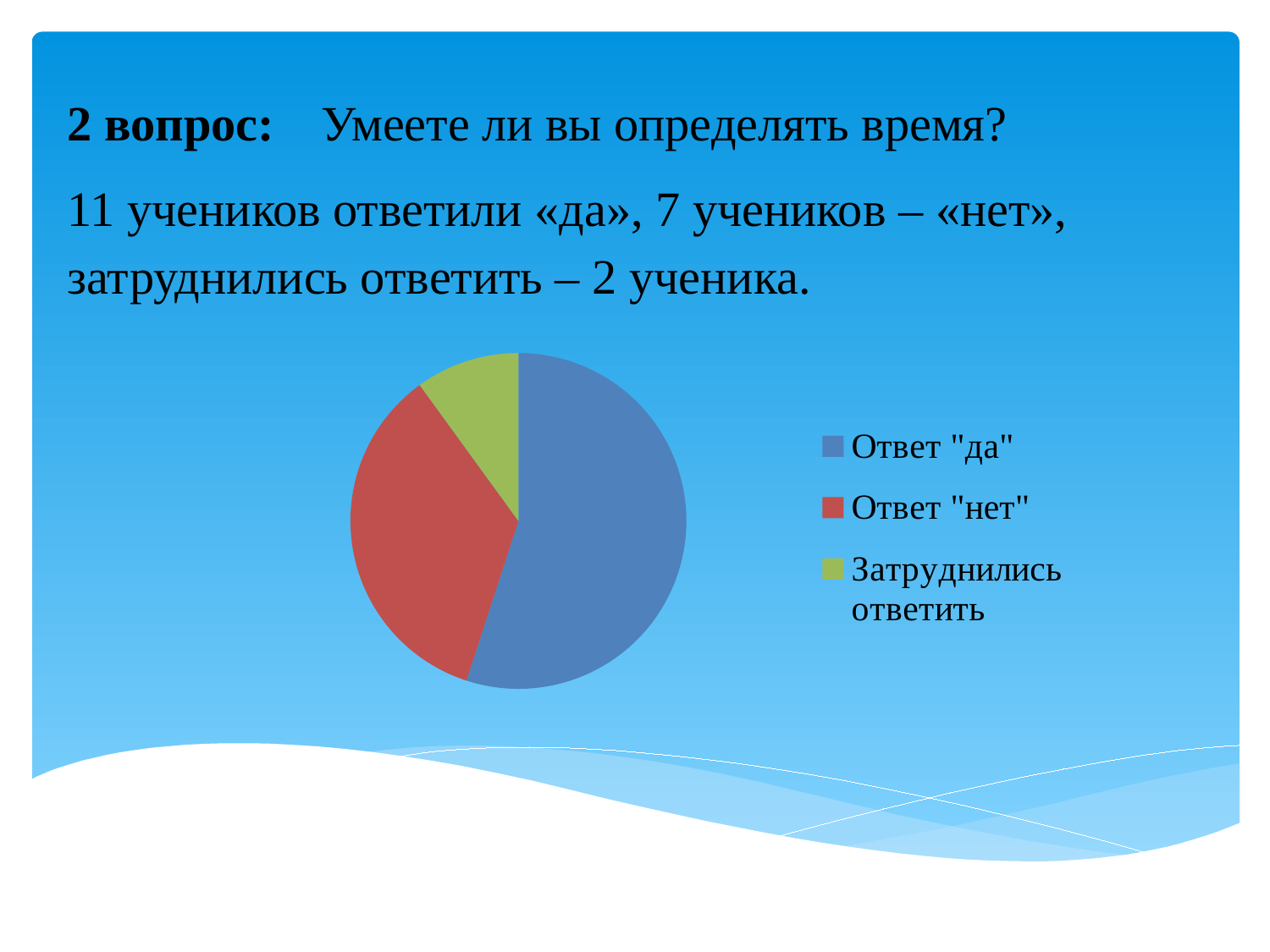
What colour is the Ответ "нет" slice in the pie chart? red According to the slide, how many pupils answered "нет"? 7 Which slice is larger in the pie chart: Ответ "нет" or Затруднились ответить? Ответ "нет" How many more pupils answered "да" than "нет"? 4 According to the slide, how many pupils found it difficult to answer (Затруднились ответить)? 2 What share of the pie does the Ответ "да" slice represent? 55% What kind of chart is shown on the slide? pie chart How many slices does the pie chart have? 3 Which category has the largest slice in the pie chart? Ответ "да" According to the slide, how many pupils answered "да"? 11 How many entries does the legend of the pie chart list? 3 Which category has the smallest slice in the pie chart? Затруднились ответить